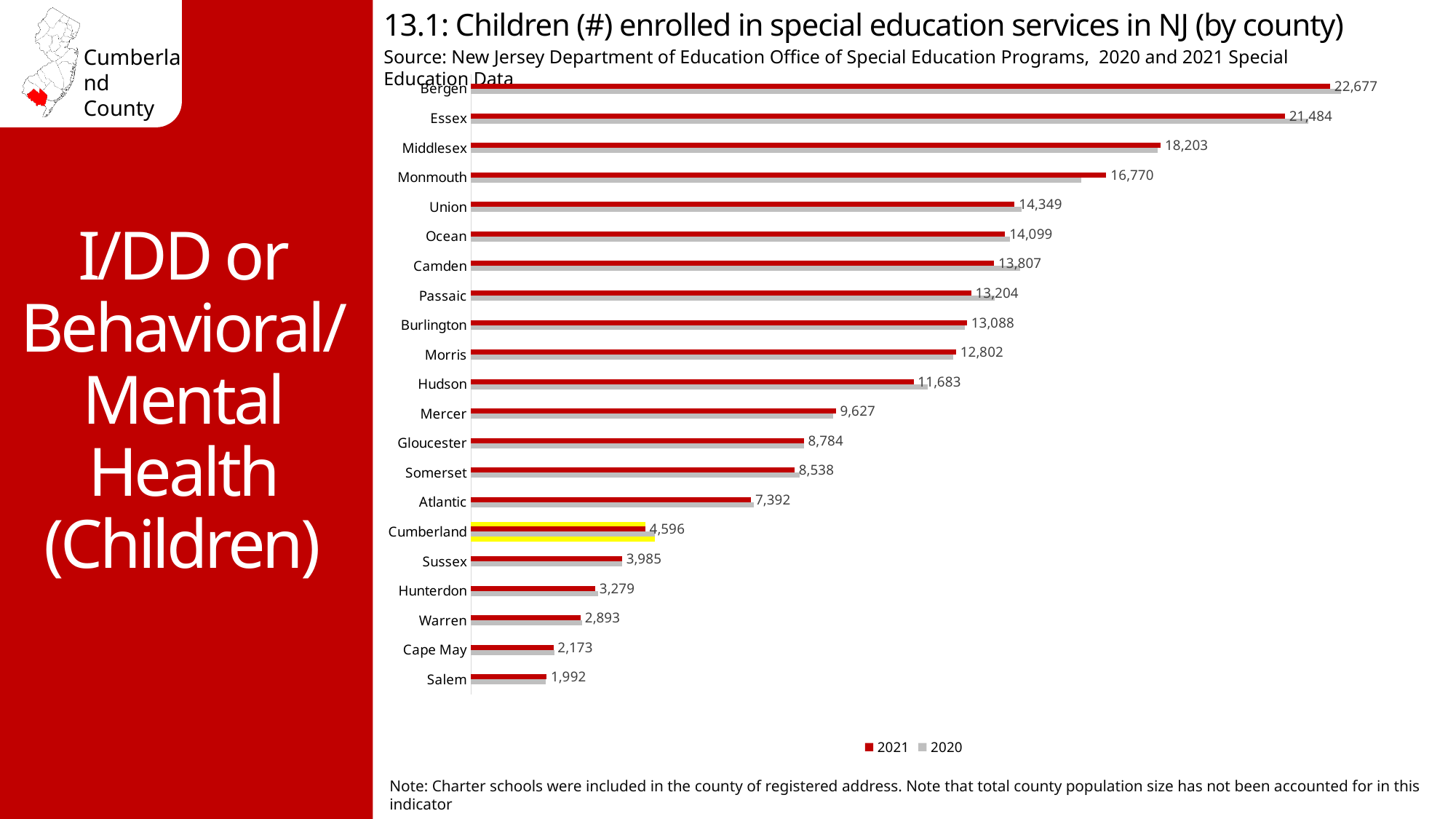
Which year is represented by the red bars in the legend? 2021 What is the 2021 value for Bergen County? 22,677 What is the 2021 value for Cumberland County? 4,596 What is the difference between the 2021 values for Cumberland and Sussex? 611 Which county has the highest number of children enrolled in special education services in 2021? Bergen What is the difference between the 2021 values for Bergen and Essex? 1,193 How many series does the legend list? 2 Which county has a larger 2021 value, Middlesex or Monmouth? Middlesex Which county has the lowest number of children enrolled in special education services in 2021? Salem What is the 2021 value for Atlantic County? 7,392 How many counties are shown on the chart? 21 What kind of chart is shown on the slide? Bar chart